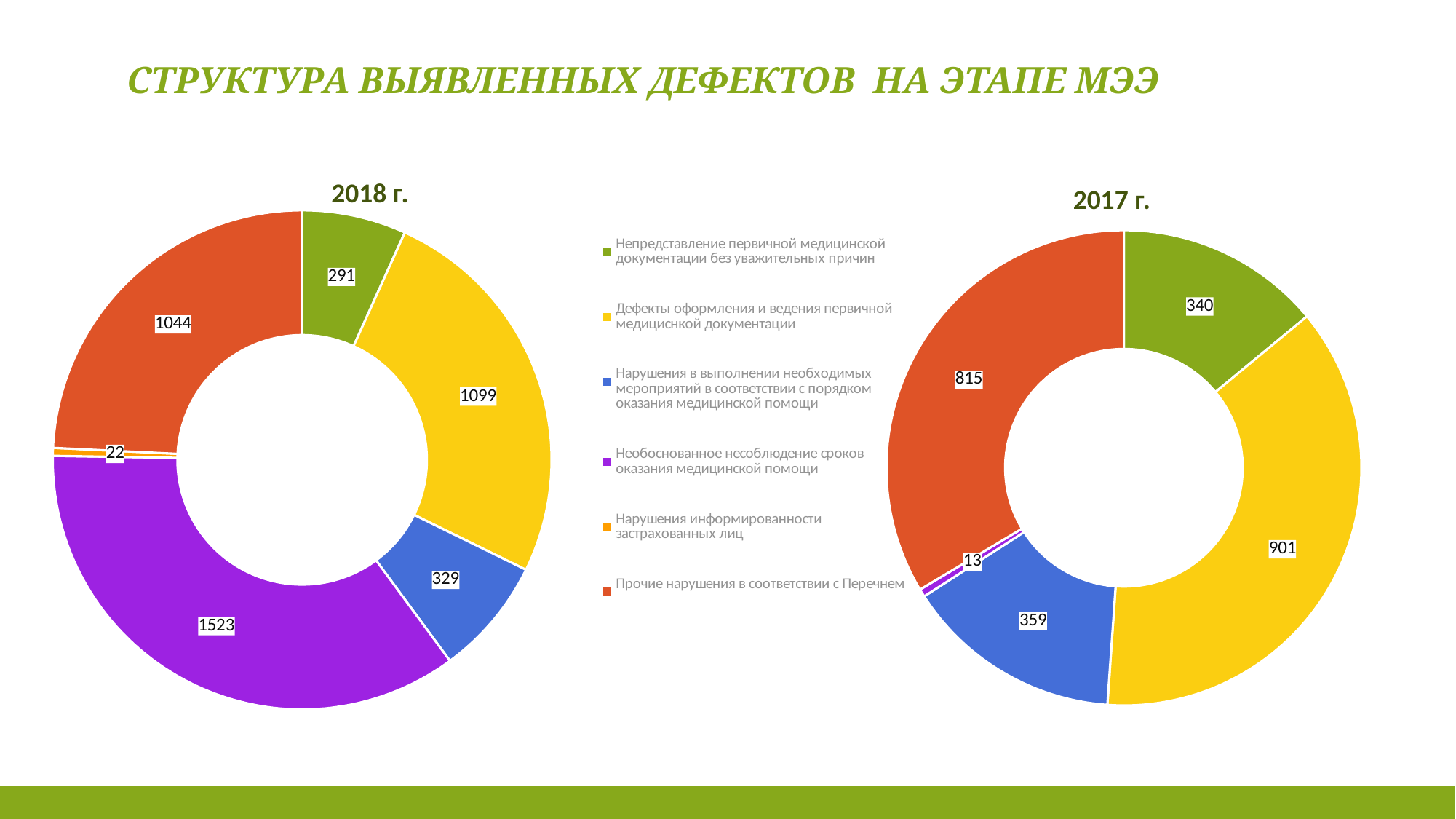
How many categories does the legend list? 6 In the 2018 г. chart, which is larger: the value for Дефекты оформления и ведения первичной медицинской документации or the value for Нарушения в выполнении необходимых мероприятий? Дефекты оформления и ведения первичной медицинской документации In the 2018 г. chart, what is the value for Дефекты оформления и ведения первичной медицинской документации? 1099 In the 2018 г. chart, which category has the largest value? Необоснованное несоблюдение сроков оказания медицинской помощи In the 2017 г. chart, what is the value for Нарушения в выполнении необходимых мероприятий в соответствии с порядком оказания медицинской помощи? 359 In the 2018 г. chart, what is the value for Непредставление первичной медицинской документации без уважительных причин? 291 In the 2017 г. chart, what is the difference between the value for Нарушения в выполнении необходимых мероприятий and the value for Непредставление первичной медицинской документации? 19 What kind of chart is used for the 2018 г. and 2017 г. data? doughnut chart In the 2017 г. chart, which category has the largest value? Дефекты оформления и ведения первичной медицинской документации In the 2018 г. chart, what is the difference between the value for Необоснованное несоблюдение сроков оказания медицинской помощи and the value for Прочие нарушения в соответствии с Перечнем? 479 What colour represents Прочие нарушения в соответствии с Перечнем in the charts? red In the 2017 г. chart, what is the value for Прочие нарушения в соответствии с Перечнем? 815